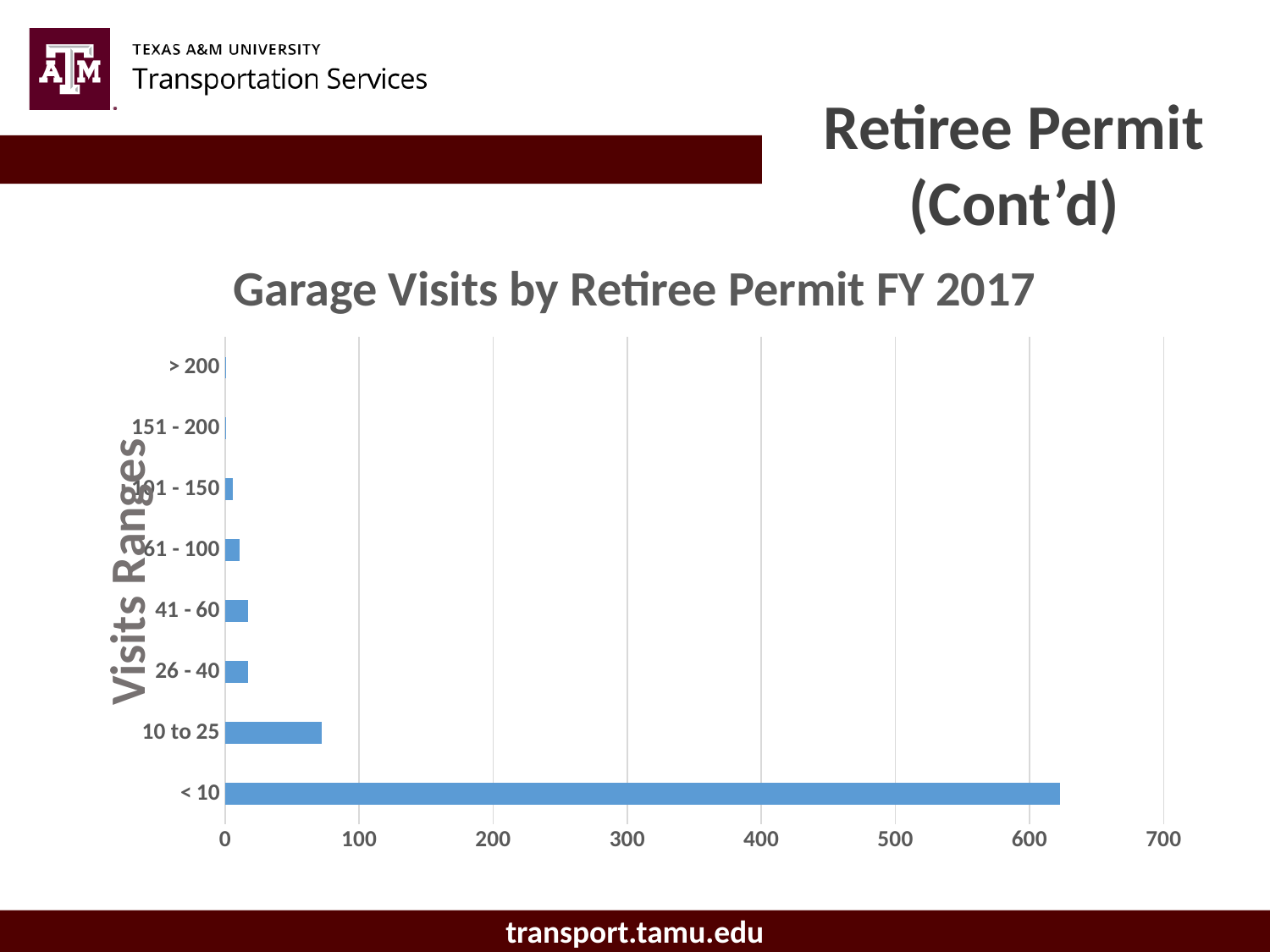
Which visit range has the highest value in the chart? < 10 Which has a larger value, the 61 - 100 range or the 151 - 200 range? 61 - 100 Which has a larger value, the < 10 range or the 10 to 25 range? < 10 What type of chart is shown on the slide? bar chart What is the label on the vertical axis of the chart? Visits Ranges Which has a larger value, the 10 to 25 range or the 26 - 40 range? 10 to 25 Do the values generally rise or fall as the visit ranges increase from < 10 to > 200? fall Is the value for the 10 to 25 visit range greater or less than 100? less What is the title of the chart? Garage Visits by Retiree Permit FY 2017 How many visit range categories are shown in the chart? 8 Is the value for the 41 - 60 visit range greater or less than 100? less Is the value for the < 10 visit range greater or less than 600? greater